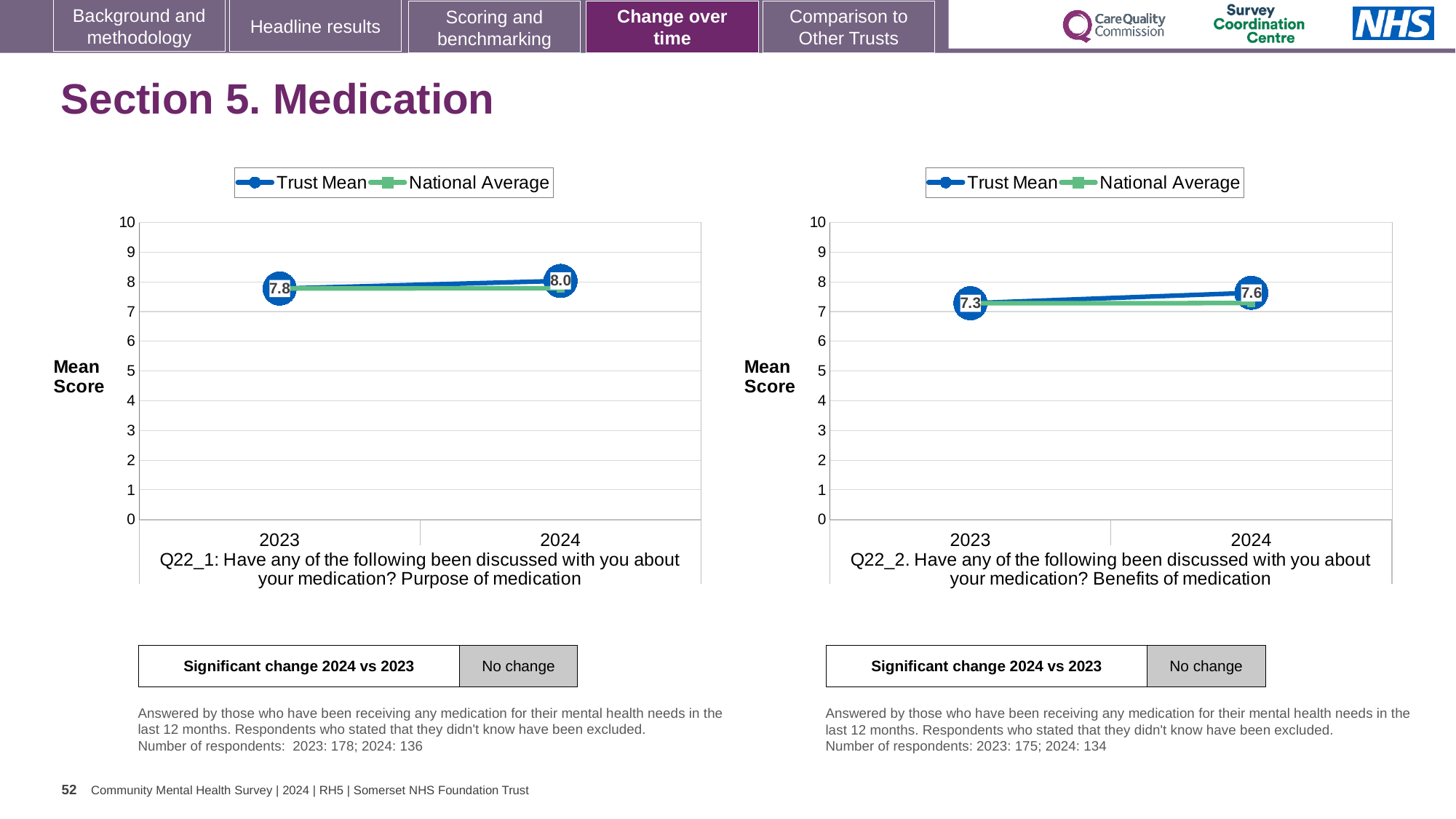
In the left chart (Q22_1), by how much did the Trust Mean change from 2023 to 2024? 0.2 In the left chart (Q22_1: Purpose of medication), what is the Trust Mean for 2024? 8.0 What kind of chart is the left chart (Q22_1)? line chart In the right chart (Q22_2), is the National Average for 2023 greater or less than 5? greater In the right chart (Q22_2), by how much did the Trust Mean change from 2023 to 2024? 0.3 How many series does the legend of the left chart (Q22_1) list? 2 In the left chart (Q22_1: Purpose of medication), what is the Trust Mean for 2023? 7.8 In the right chart (Q22_2), does the Trust Mean rise or fall from 2023 to 2024? rise How many years are plotted on the x axis of the right chart (Q22_2)? 2 In the left chart (Q22_1), which year has the higher Trust Mean, 2023 or 2024? 2024 In the right chart (Q22_2: Benefits of medication), what is the Trust Mean for 2023? 7.3 In the right chart (Q22_2: Benefits of medication), what is the Trust Mean for 2024? 7.6